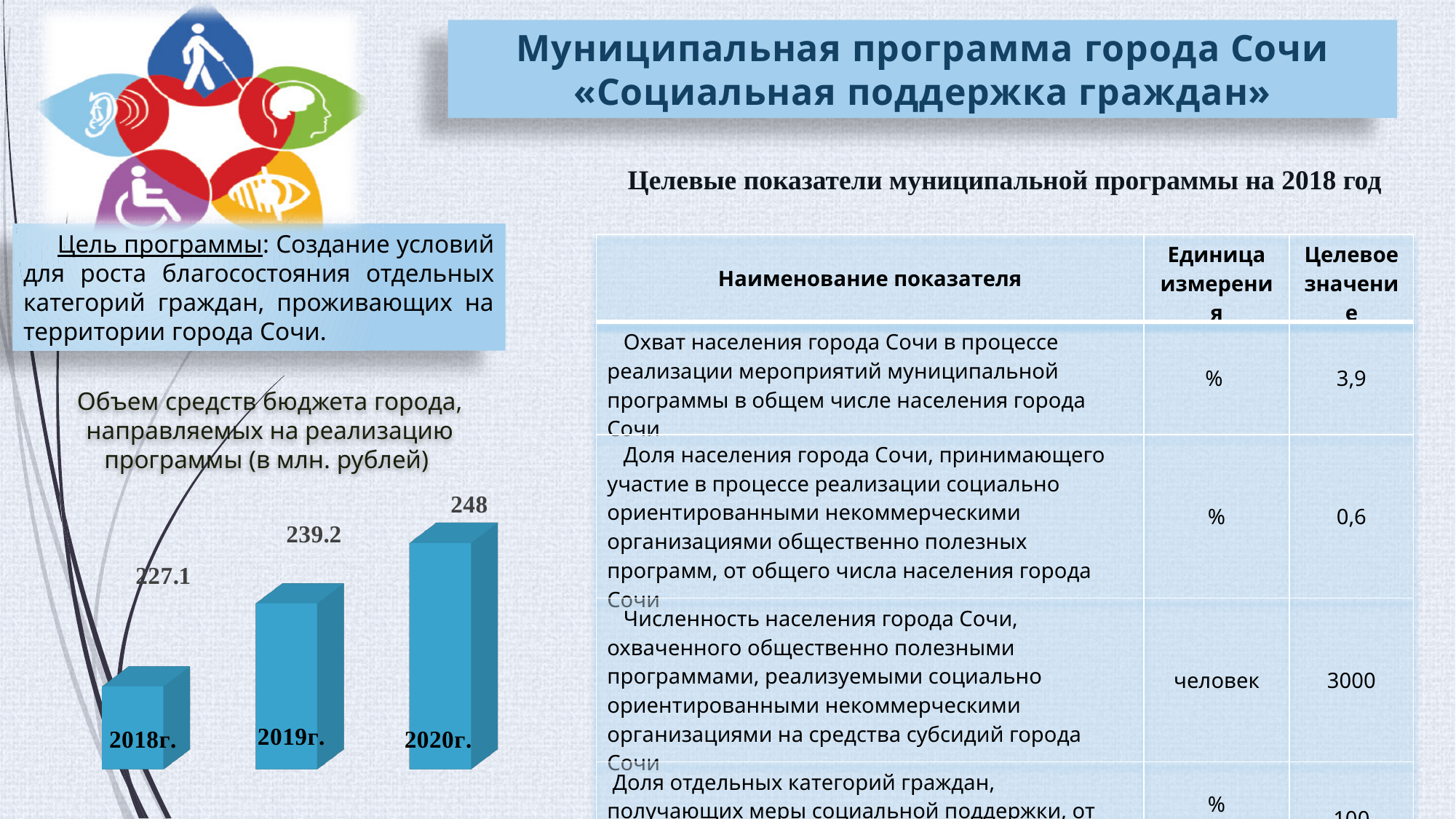
What is the difference between the values for 2020г. and 2018г.? 20.9 Do the values in the chart rise or fall from 2018г. to 2020г.? Rise What is the value for 2018г. in the chart? 227.1 Which is larger, the value for 2019г. or the value for 2020г.? 2020г. What type of chart is shown on the slide? Bar chart What is the value for 2020г. in the chart? 248 Which year has the lowest value in the chart? 2018г. What is the value for 2019г. in the chart? 239.2 What is the difference between the values for 2019г. and 2018г.? 12.1 In what units are the values in the chart expressed, according to its title? млн. рублей How many bars are shown in the chart? 3 Which year has the highest value in the chart? 2020г.